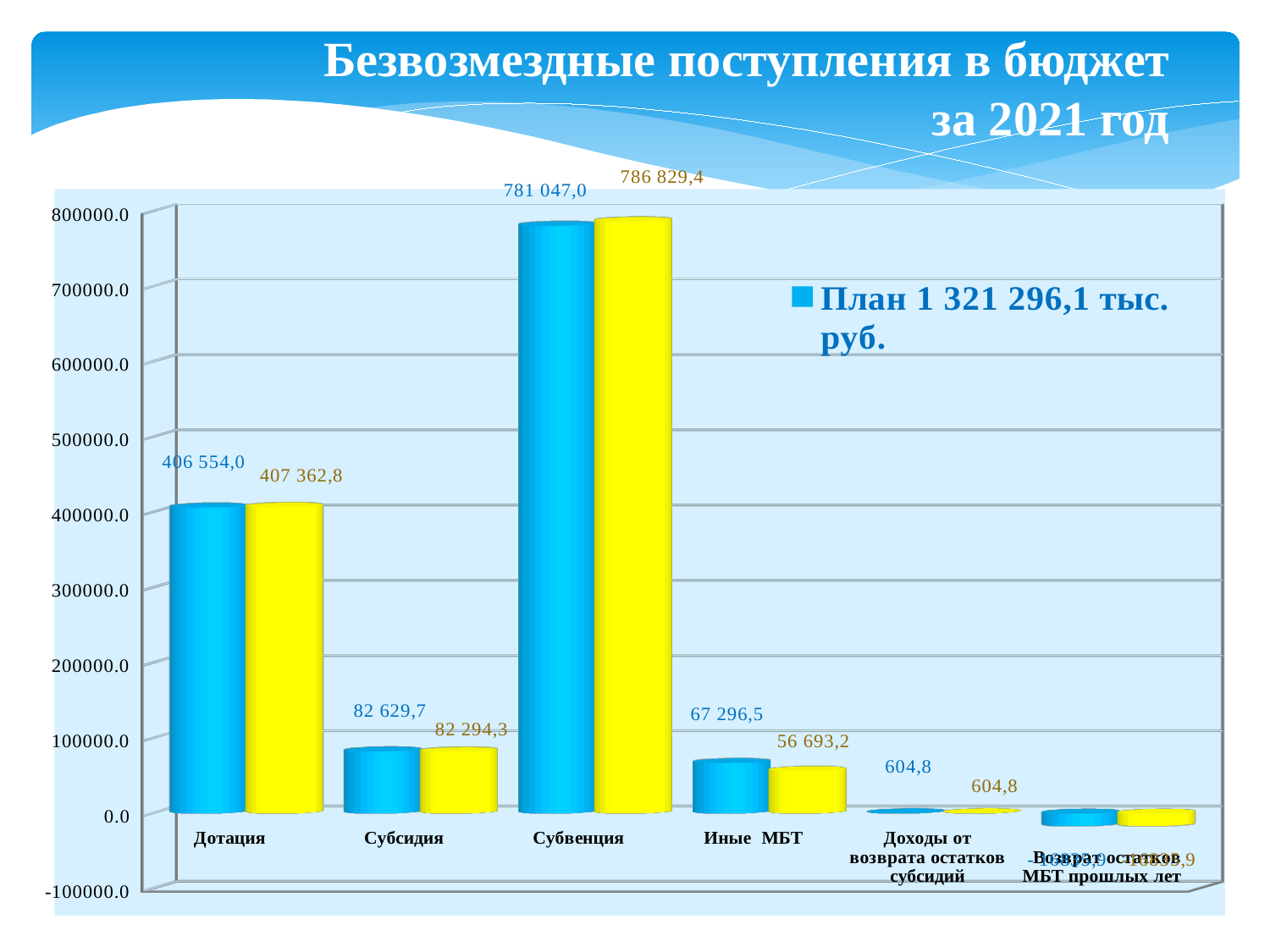
How many categories are shown on the x axis of the chart? 6 For Субвенция, how much larger is the yellow bar (786 829,4) than the blue bar (781 047,0)? 5 782,4 For Иные МБТ, what is the difference between the blue bar (67 296,5) and the yellow bar (56 693,2)? 10 603,3 What kind of chart is shown on the slide? bar chart Is the value of the blue bar for Субсидия greater or less than 100000? less What is the value of the yellow bar for Субвенция? 786 829,4 What is the value of the blue (План) bar for Дотация? 406 554,0 What is the value of the yellow bar for Иные МБТ? 56 693,2 What is the value of the yellow bar for Доходы от возврата остатков субсидий? 604,8 What is the value of the blue (План) bar for Субсидия? 82 629,7 For Иные МБТ, which bar is larger, the blue one or the yellow one? the blue one Which category has the highest blue (План) bar? Субвенция